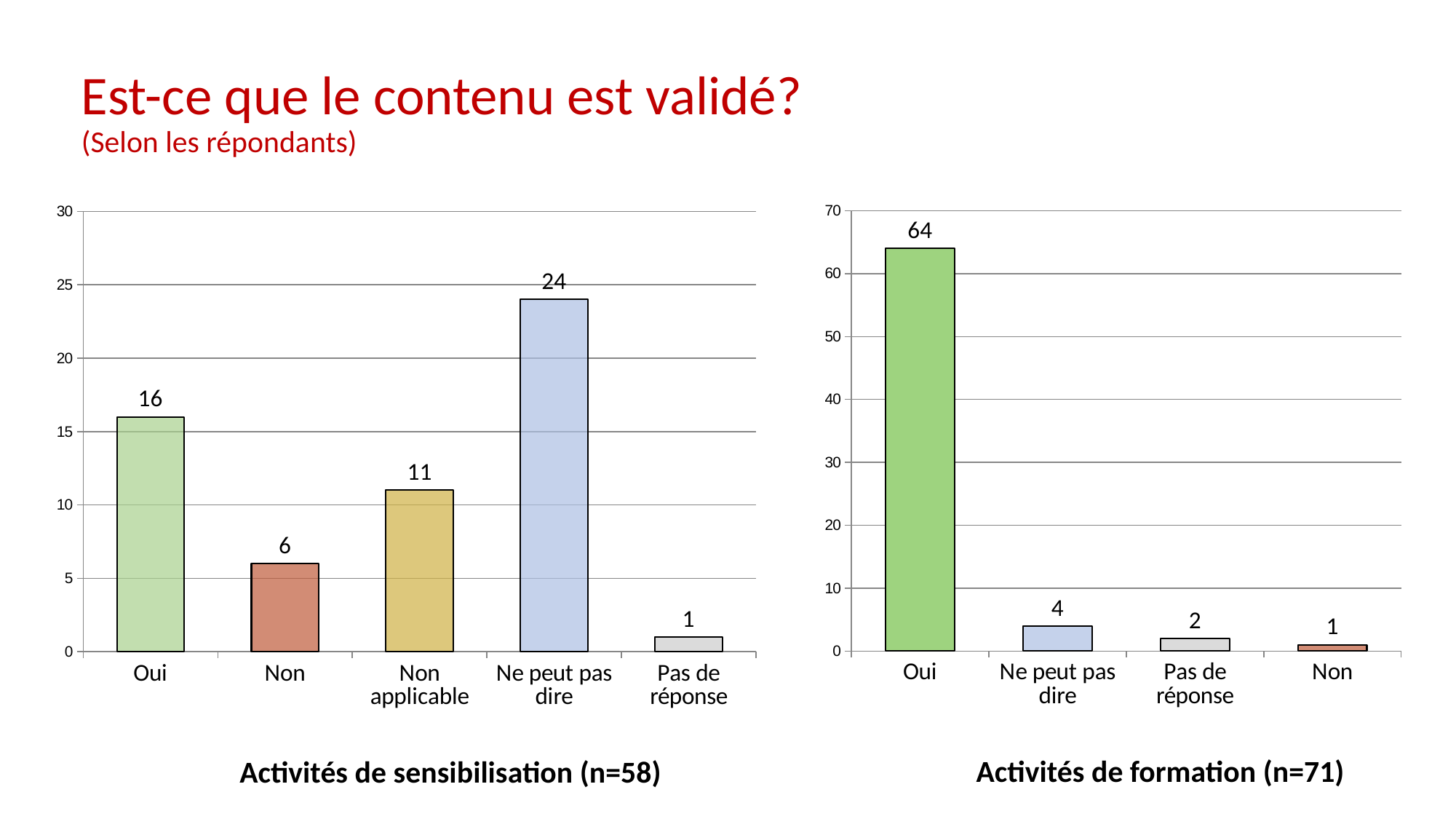
In the 'Activités de formation (n=71)' chart, is the value for 'Oui' greater or less than 60? greater In the 'Activités de formation (n=71)' chart, what is the difference between 'Oui' and 'Ne peut pas dire'? 60 How many categories are shown in the 'Activités de formation (n=71)' chart? 4 In the 'Activités de sensibilisation (n=58)' chart, which is larger: 'Non' or 'Non applicable'? Non applicable What kind of chart is the 'Activités de formation (n=71)' chart? Bar chart In the 'Activités de sensibilisation (n=58)' chart, which category has the highest value? Ne peut pas dire How many categories are shown in the 'Activités de sensibilisation (n=58)' chart? 5 In the 'Activités de formation (n=71)' chart, which category has the lowest value? Non In the 'Activités de sensibilisation (n=58)' chart, what is the value for 'Pas de réponse'? 1 In the 'Activités de formation (n=71)' chart, what is the value for 'Oui'? 64 In the 'Activités de sensibilisation (n=58)' chart, what is the difference between 'Ne peut pas dire' and 'Oui'? 8 In the 'Activités de sensibilisation (n=58)' chart, what is the value for 'Ne peut pas dire'? 24